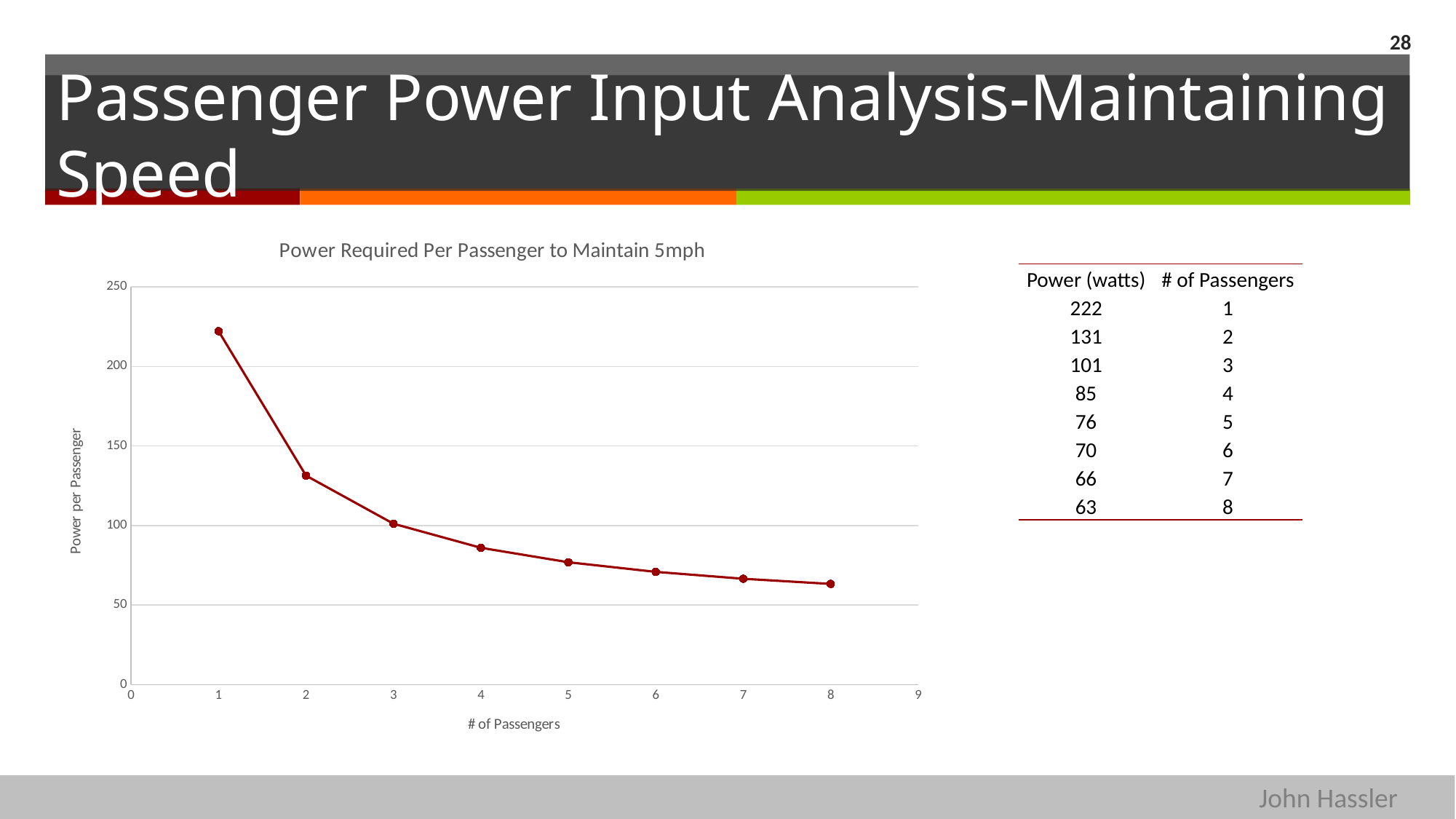
What is the title of the chart? Power Required Per Passenger to Maintain 5mph What kind of chart is shown on the slide? line chart Which has a higher power per passenger: 3 passengers or 6 passengers? 3 passengers According to the slide, what is the power per passenger (watts) for 4 passengers? 85 At which number of passengers is the power per passenger lowest? 8 How many data points are plotted on the chart? 8 Is the power per passenger for 2 passengers greater or less than 150? less At which number of passengers is the power per passenger highest? 1 Does the power per passenger rise or fall as the number of passengers increases? fall What is the difference in power per passenger between 1 passenger and 2 passengers? 91 According to the slide, what is the power per passenger (watts) for 8 passengers? 63 According to the slide, what is the power per passenger (watts) for 1 passenger? 222